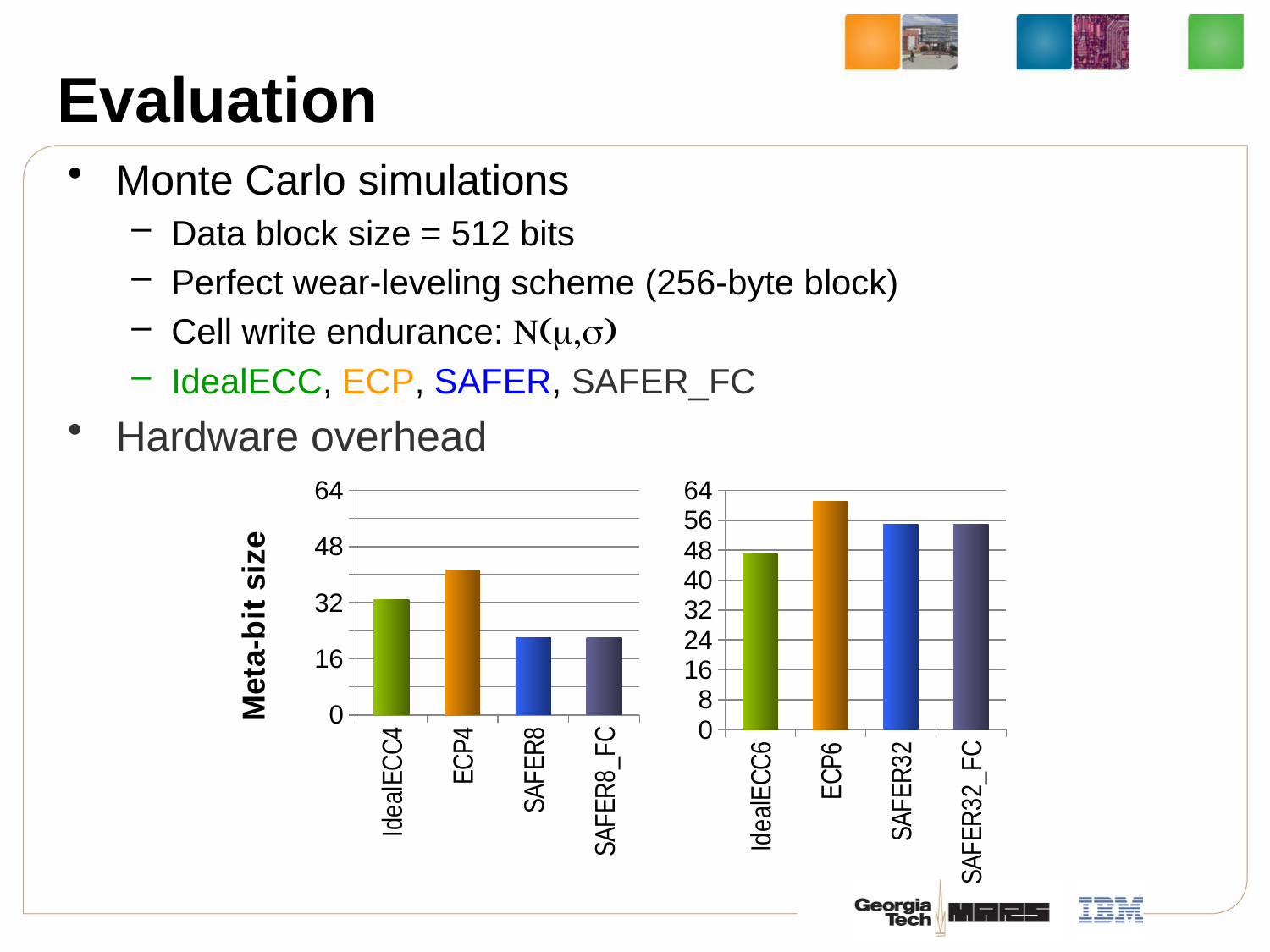
In the left chart, which category has the highest meta-bit size? ECP4 In the left chart, which is larger, the value for IdealECC4 or the value for SAFER8? IdealECC4 In the right chart, is the value for ECP6 greater or less than 56? greater In the left chart, is the value for ECP4 greater or less than 32? greater How many categories are shown in the right chart? 4 In the right chart, which category has the highest meta-bit size? ECP6 What kind of chart is the left chart? bar chart How many categories are shown in the left chart? 4 In the right chart, which category has the lowest meta-bit size? IdealECC6 In the left chart, is the value for SAFER8 greater or less than 32? less What is the y-axis label of the left chart? Meta-bit size